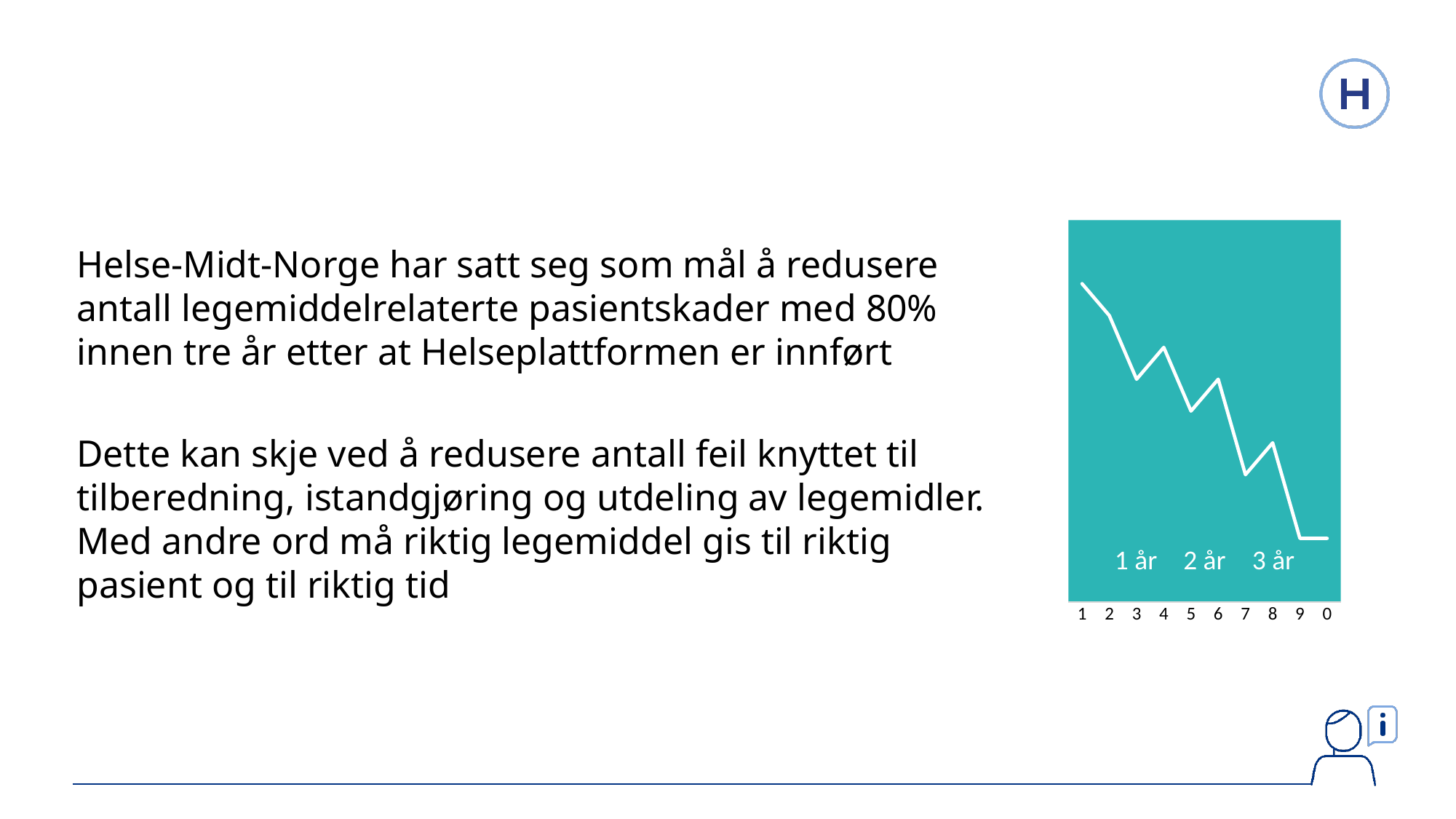
How many tick labels are shown along the x axis of the chart? 10 What are the three year labels printed inside the chart area? 1 år, 2 år, 3 år What is the background colour of the chart area? teal At which x-axis label does the line reach its highest point? 1 Does the line in the chart generally rise or fall from left to right? fall What kind of chart is shown on the right side of the slide? line chart Is the line at x-axis label 0 higher or lower than at x-axis label 1? lower